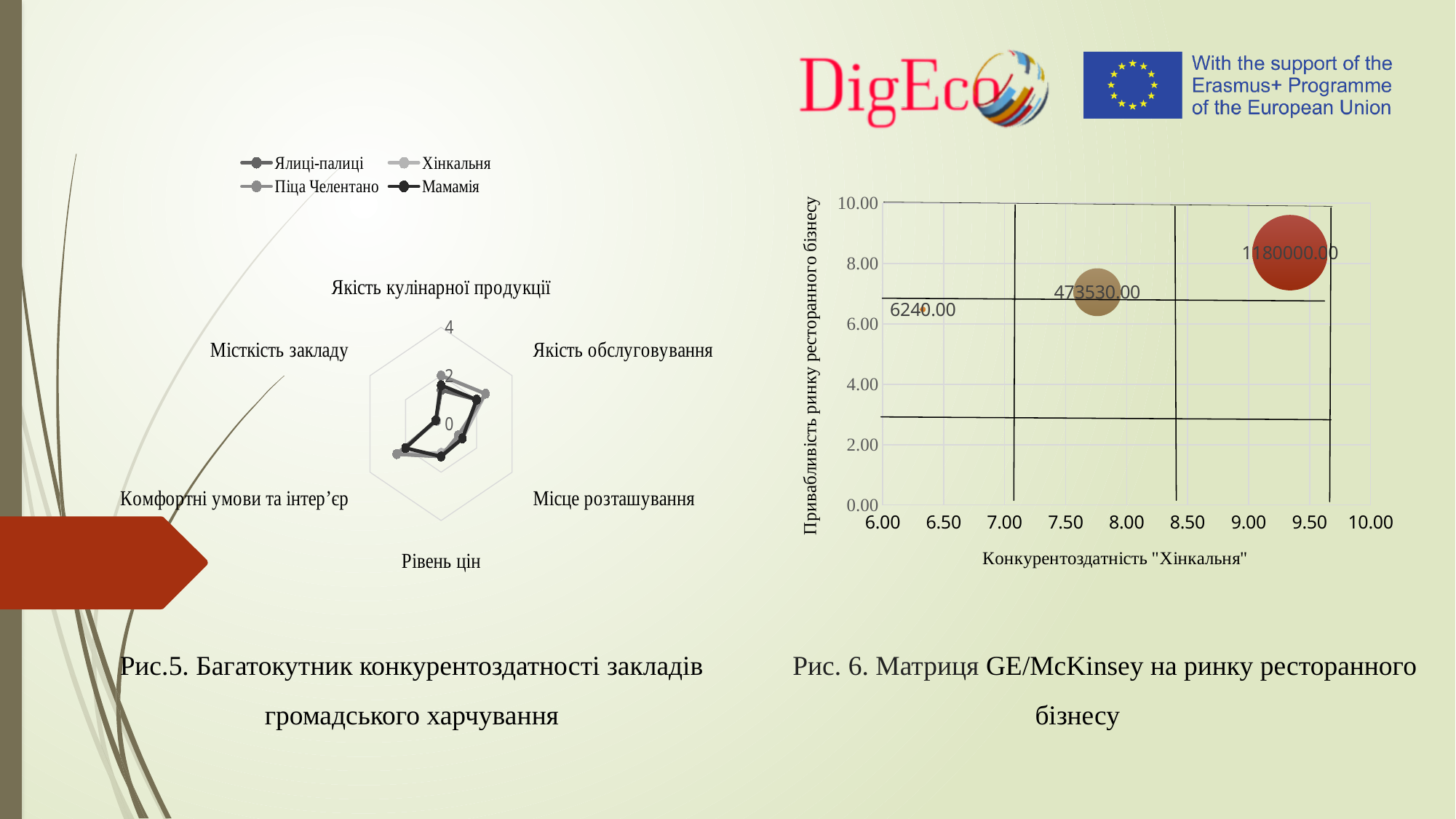
What is the maximum value shown on the axis of the radar chart Рис.5? 4 What kind of chart is Рис.5 (the left chart)? radar chart How many categories (axes) does the radar chart Рис.5 have? 6 What kind of chart is Рис. 6 (the right chart)? bubble chart In Рис. 6 (the right chart), what is the label of the largest bubble? 1180000.00 In Рис. 6 (the right chart), what is the label of the smallest bubble? 6240.00 In Рис. 6 (the right chart), what is the difference between the bubble labelled 1180000.00 and the bubble labelled 473530.00? 706470.00 Which series in the legend of Рис.5 is listed last? Мамамія In Рис. 6 (the right chart), is the x-axis value of the bubble labelled 6240.00 greater or less than 7.00? less How many series does the legend of Рис.5 (the left chart) list? 4 How many bubbles are plotted in Рис. 6 (the right chart)? 3 In Рис. 6 (the right chart), is the y-axis value of the bubble labelled 1180000.00 greater or less than 8.00? greater